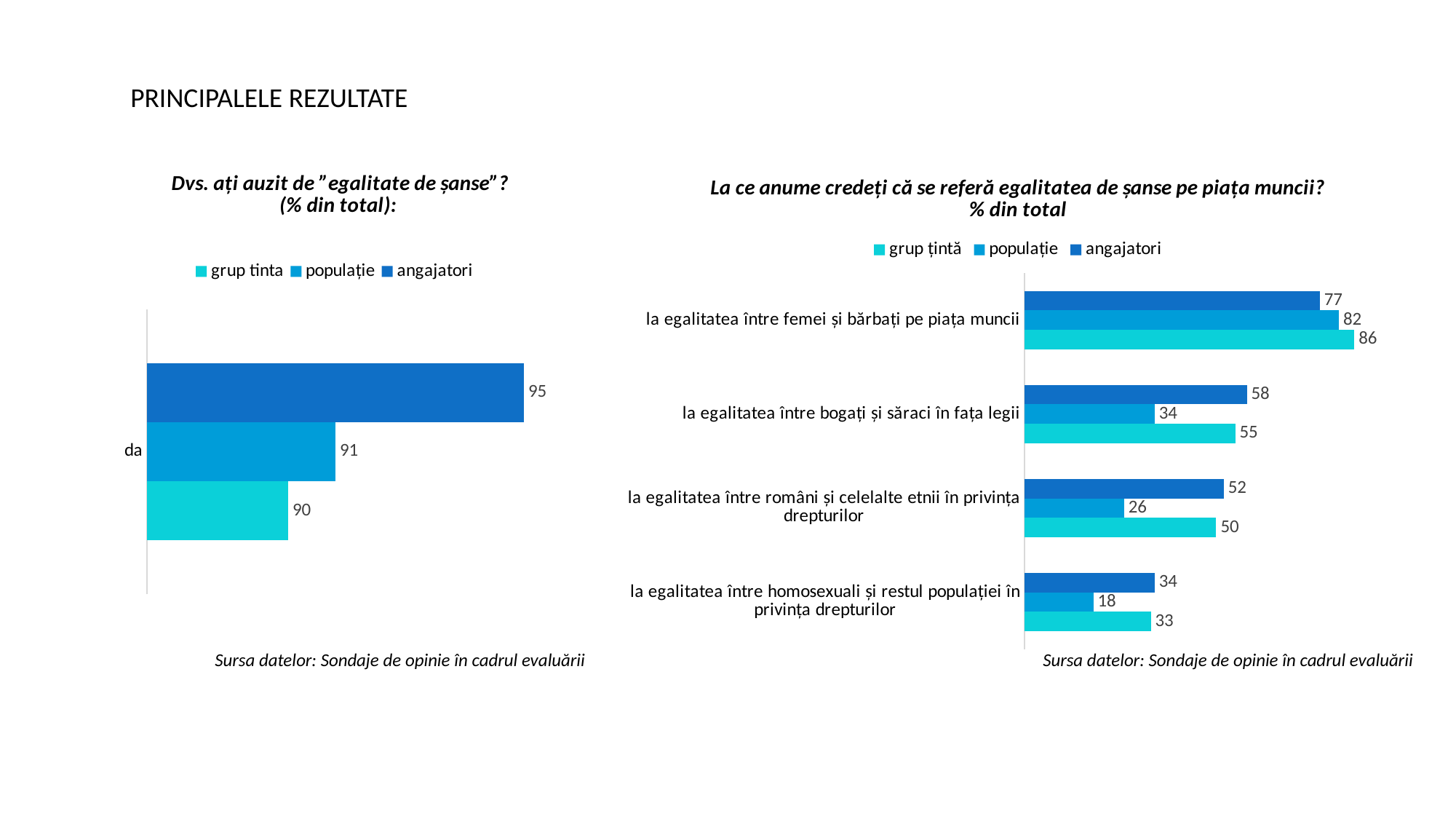
In the right chart ("La ce anume credeți că se referă egalitatea de șanse pe piața muncii?"), which is larger for "la egalitatea între bogați și săraci în fața legii": the angajatori value or the grup țintă value? angajatori In the left chart ("Dvs. ați auzit de "egalitate de șanse"?"), how many series does the legend list? 3 In the left chart ("Dvs. ați auzit de "egalitate de șanse"?"), what is the value for angajatori? 95 In the right chart ("La ce anume credeți că se referă egalitatea de șanse pe piața muncii?"), what is the populație value for "la egalitatea între bogați și săraci în fața legii"? 34 In the right chart ("La ce anume credeți că se referă egalitatea de șanse pe piața muncii?"), what is the grup țintă value for "la egalitatea între femei și bărbați pe piața muncii"? 86 In the right chart ("La ce anume credeți că se referă egalitatea de șanse pe piața muncii?"), which category has the lowest populație value? la egalitatea între homosexuali și restul populației în privința drepturilor In the left chart ("Dvs. ați auzit de "egalitate de șanse"?"), which series has the highest value? angajatori What type of chart is the right chart ("La ce anume credeți că se referă egalitatea de șanse pe piața muncii?")? bar chart In the left chart ("Dvs. ați auzit de "egalitate de șanse"?"), what is the value for grup tinta? 90 In the right chart ("La ce anume credeți că se referă egalitatea de șanse pe piața muncii?"), how many categories are shown? 4 In the left chart ("Dvs. ați auzit de "egalitate de șanse"?"), what is the difference between the angajatori and populație values? 4 In the right chart ("La ce anume credeți că se referă egalitatea de șanse pe piața muncii?"), what is the difference between the angajatori and populație values for "la egalitatea între români și celelalte etnii în privința drepturilor"? 26